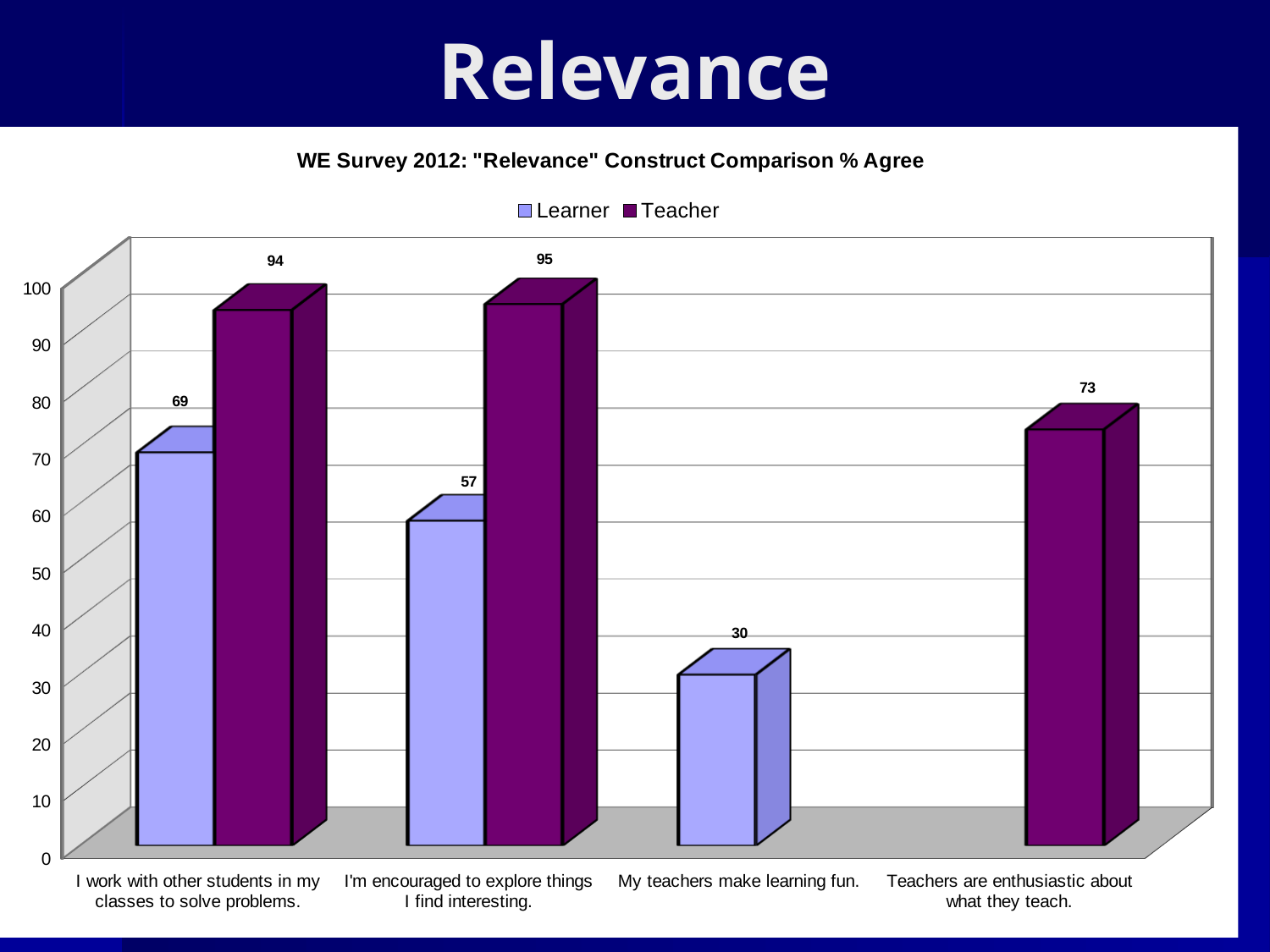
Which category has the lowest Learner value? My teachers make learning fun. What is the Learner value for "I work with other students in my classes to solve problems."? 69 What is the Teacher value for "Teachers are enthusiastic about what they teach."? 73 How many categories are shown on the x axis? 4 How many series does the legend list? 2 What kind of chart is shown on the slide? Bar chart Which category has the highest Teacher value? I'm encouraged to explore things I find interesting. Which is larger: the Learner value for "I'm encouraged to explore things I find interesting." or the Learner value for "I work with other students in my classes to solve problems."? I work with other students in my classes to solve problems. What is the title of the chart? WE Survey 2012: "Relevance" Construct Comparison % Agree What is the difference between the Teacher and Learner values for "I work with other students in my classes to solve problems."? 25 What is the Learner value for "My teachers make learning fun."? 30 What is the Teacher value for "I'm encouraged to explore things I find interesting."? 95